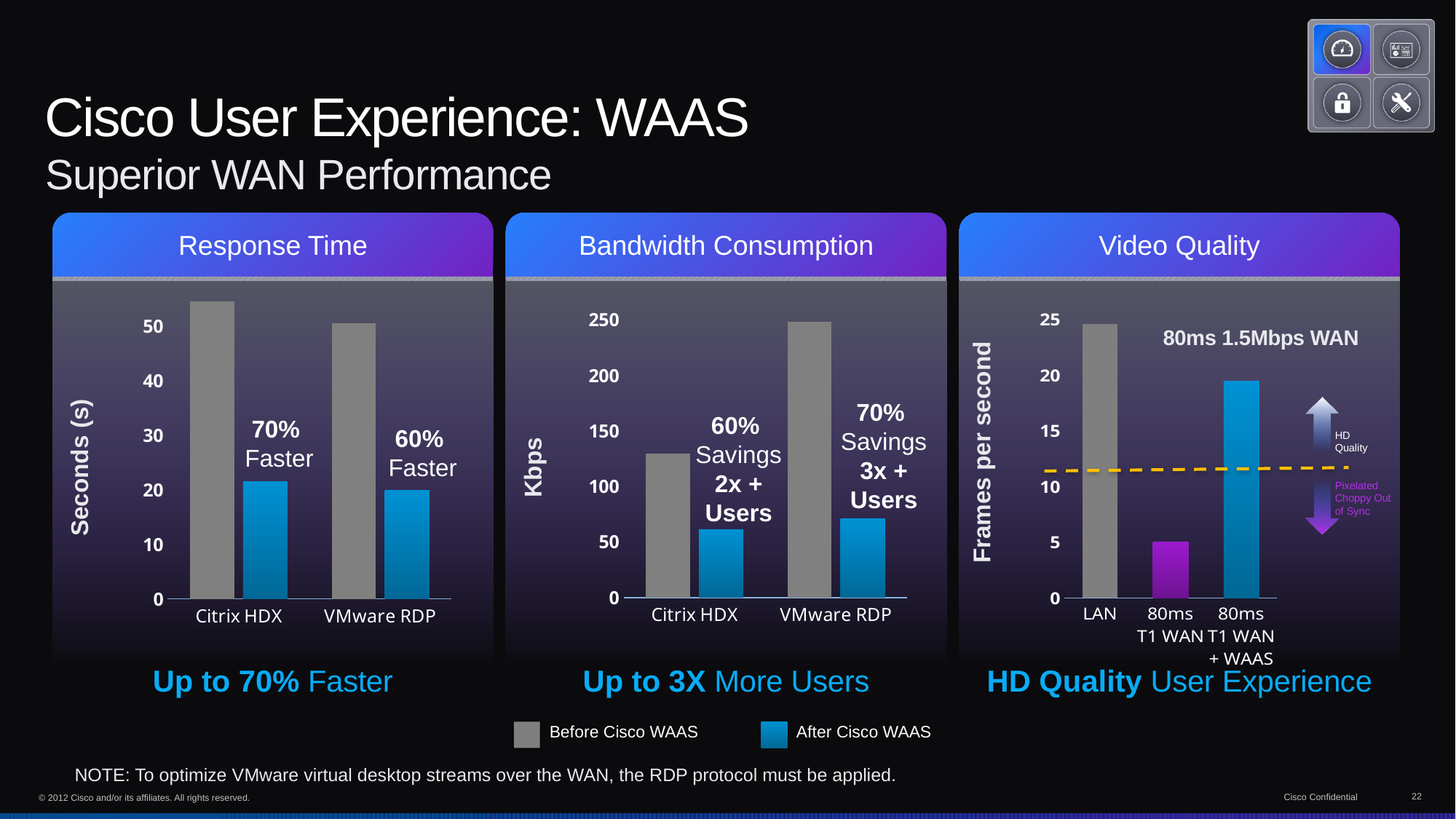
In the Video Quality chart, is the value for 80ms T1 WAN + WAAS greater or less than 15? greater In the Response Time chart, which is larger for VMware RDP: the Before Cisco WAAS bar or the After Cisco WAAS bar? Before Cisco WAAS In the Video Quality chart, which category has the lowest frames per second? 80ms T1 WAN In the Bandwidth Consumption chart, is the After Cisco WAAS value for VMware RDP greater or less than 100? less In the Bandwidth Consumption chart, is the Before Cisco WAAS value for Citrix HDX greater or less than 100? greater How many series does the legend at the bottom of the slide list? 2 How many categories are shown on the x axis of the Video Quality chart? 3 How many categories are shown on the x axis of the Response Time chart? 2 In the Bandwidth Consumption chart, which category has the higher Before Cisco WAAS value? VMware RDP What kind of chart is the Response Time chart? Bar chart